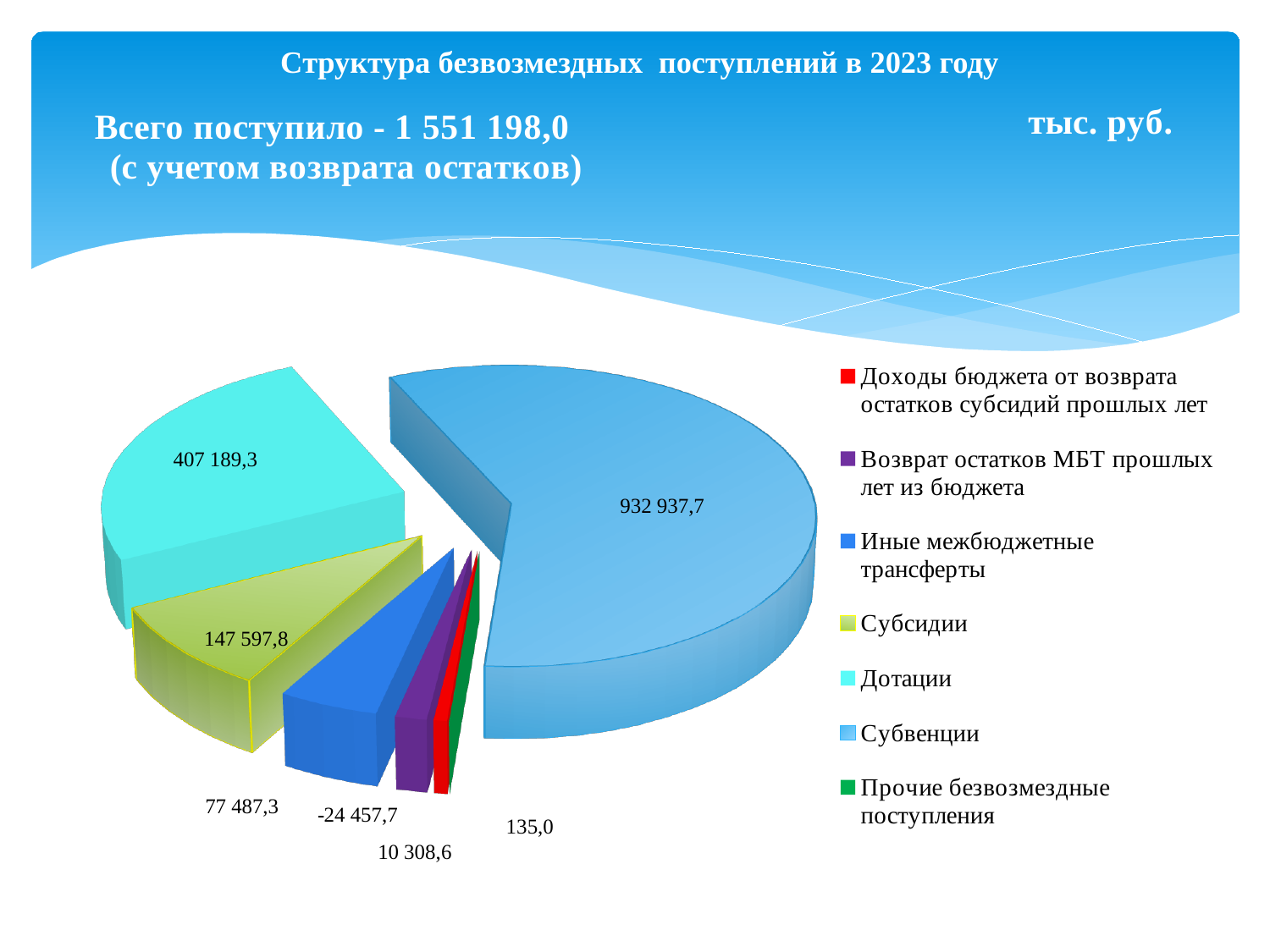
What is the difference between the values for Субвенции and Дотации? 525 748,4 What is the value for Субвенции? 932 937,7 What type of chart is shown on the slide? Pie chart What is the value for Дотации? 407 189,3 Which is larger, Дотации or Субсидии? Дотации What is the title of the slide? Структура безвозмездных поступлений в 2023 году What is the value for Возврат остатков МБТ прошлых лет из бюджета? -24 457,7 Which category has the lowest value? Возврат остатков МБТ прошлых лет из бюджета What is the value for Субсидии? 147 597,8 How many slices does the pie chart have? 7 What is the value for Иные межбюджетные трансферты? 77 487,3 Which category has the largest slice of the pie? Субвенции